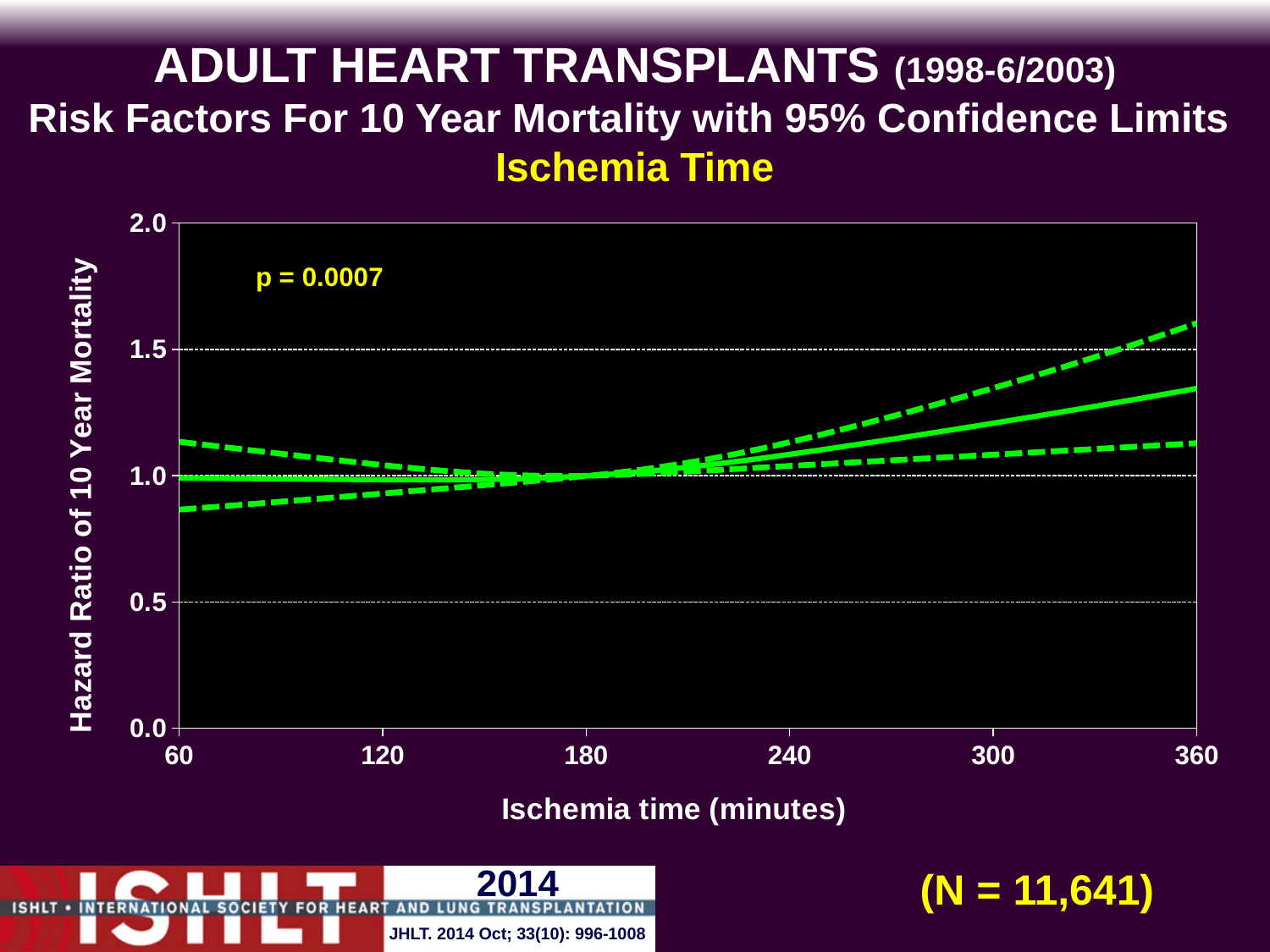
Does the solid hazard ratio line rise or fall as ischemia time increases from 180 to 360 minutes? rise Is the hazard ratio (solid line) at 360 minutes of ischemia time greater or less than 1.0? greater What kind of chart is shown on the slide? line chart What is the label of the x axis? Ischemia time (minutes) What is the range of ischemia time shown on the x axis? 60 to 360 minutes Is the hazard ratio (solid line) at 360 minutes greater or less than 1.5? less What is the p-value shown on the chart? p = 0.0007 Is the upper 95% confidence limit (upper dashed line) at 60 minutes greater or less than 1.5? less What is the maximum value shown on the y axis? 2.0 How many lines are plotted on the chart? 3